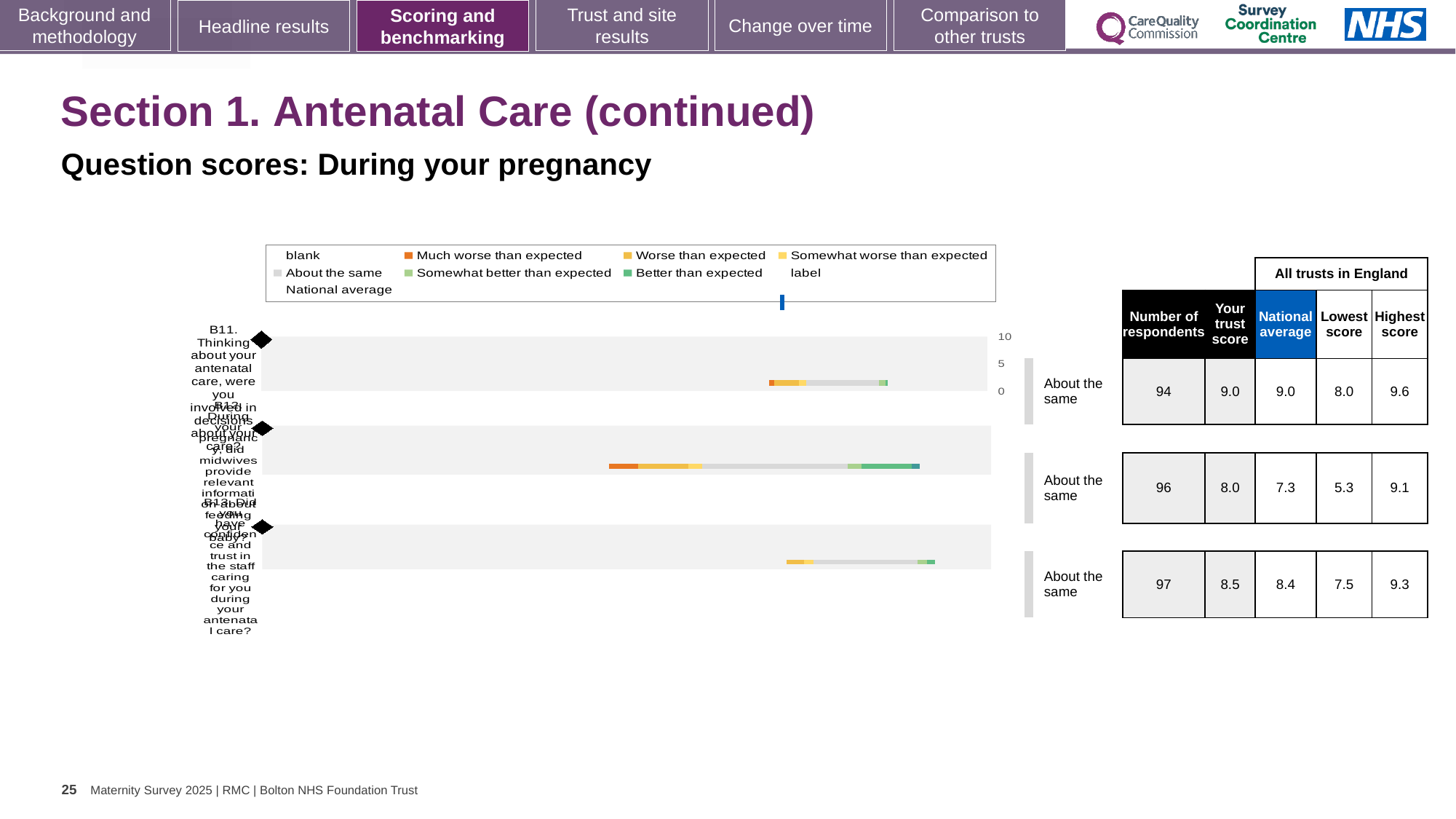
What benchmark category is shown next to the bar for question B13? About the same Which question has the highest 'Your trust score' in the table beside the chart? B11 In the table beside the chart, what is the national average for question B12? 7.3 What is the difference between the trust score and the national average for question B12? 0.7 In the table beside the chart, what is the 'Your trust score' for question B11? 9.0 How many questions (bars) are plotted in the chart? 3 What kind of chart is shown on the slide? bar chart Which question has the lowest 'Lowest score' in the table beside the chart? B12 In the table beside the chart, how many respondents are listed for question B13? 97 What is the subtitle above the chart? Question scores: During your pregnancy In the table beside the chart, what is the lowest score among all trusts in England for question B12? 5.3 In the table beside the chart, what is the highest score among all trusts in England for question B11? 9.6